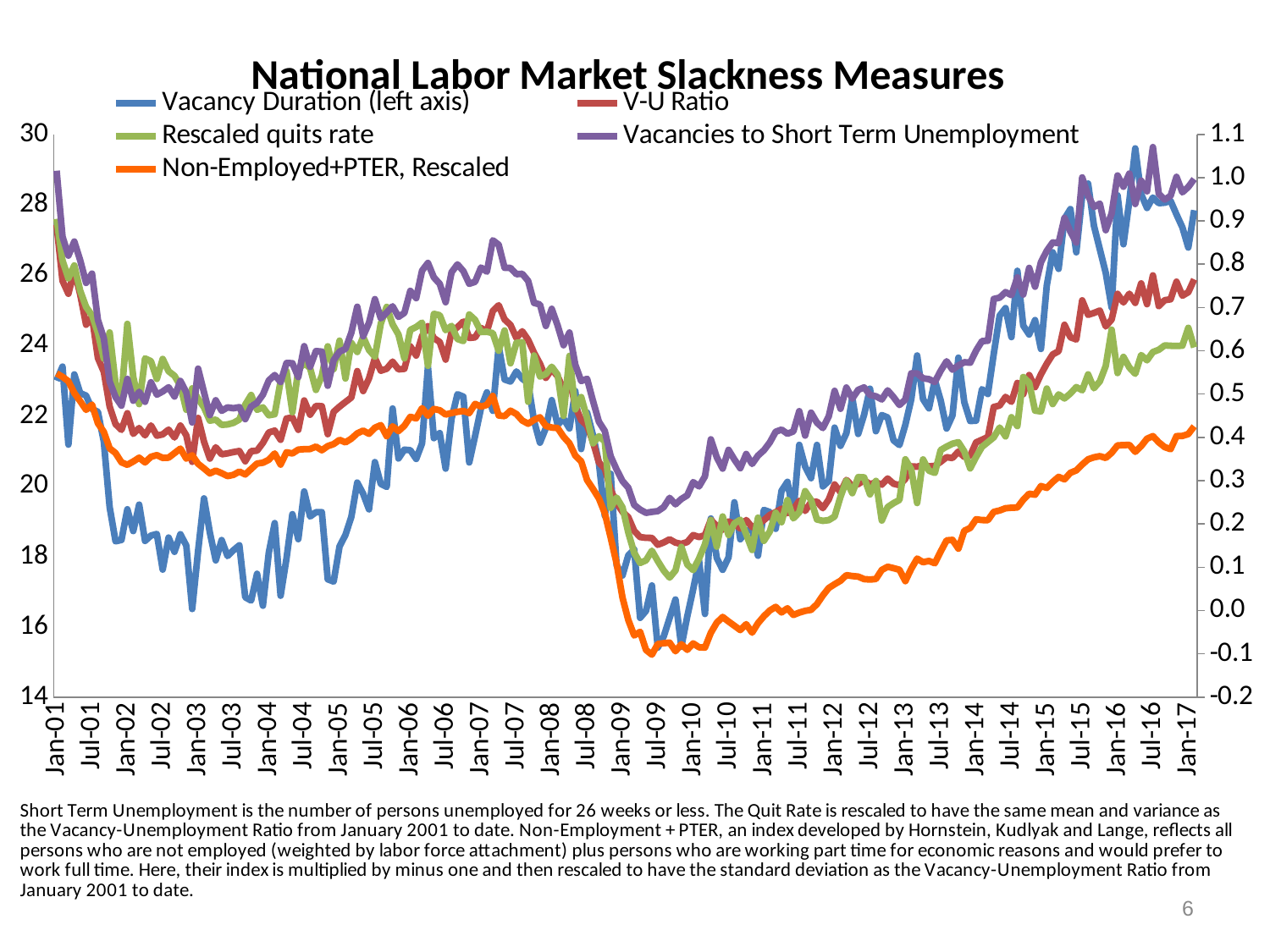
Does the Non-Employed+PTER, Rescaled series rise or fall from Jan-10 to Jan-17? rise Which series is plotted against the left axis according to the legend? Vacancy Duration How many series does the legend list? 5 Does the Vacancy Duration series rise or fall from Jan-01 to Jan-03? fall What is the title of the chart? National Labor Market Slackness Measures What kind of chart is shown on the slide? line chart Is the value for Non-Employed+PTER, Rescaled at Jul-09 greater or less than 0.0? less Is the value for Vacancies to Short Term Unemployment at Jan-17 greater or less than 0.9? greater At Jan-17, which is higher: Vacancies to Short Term Unemployment or the V-U Ratio? Vacancies to Short Term Unemployment Is the value for Non-Employed+PTER, Rescaled at Jan-17 greater or less than 0.3? greater